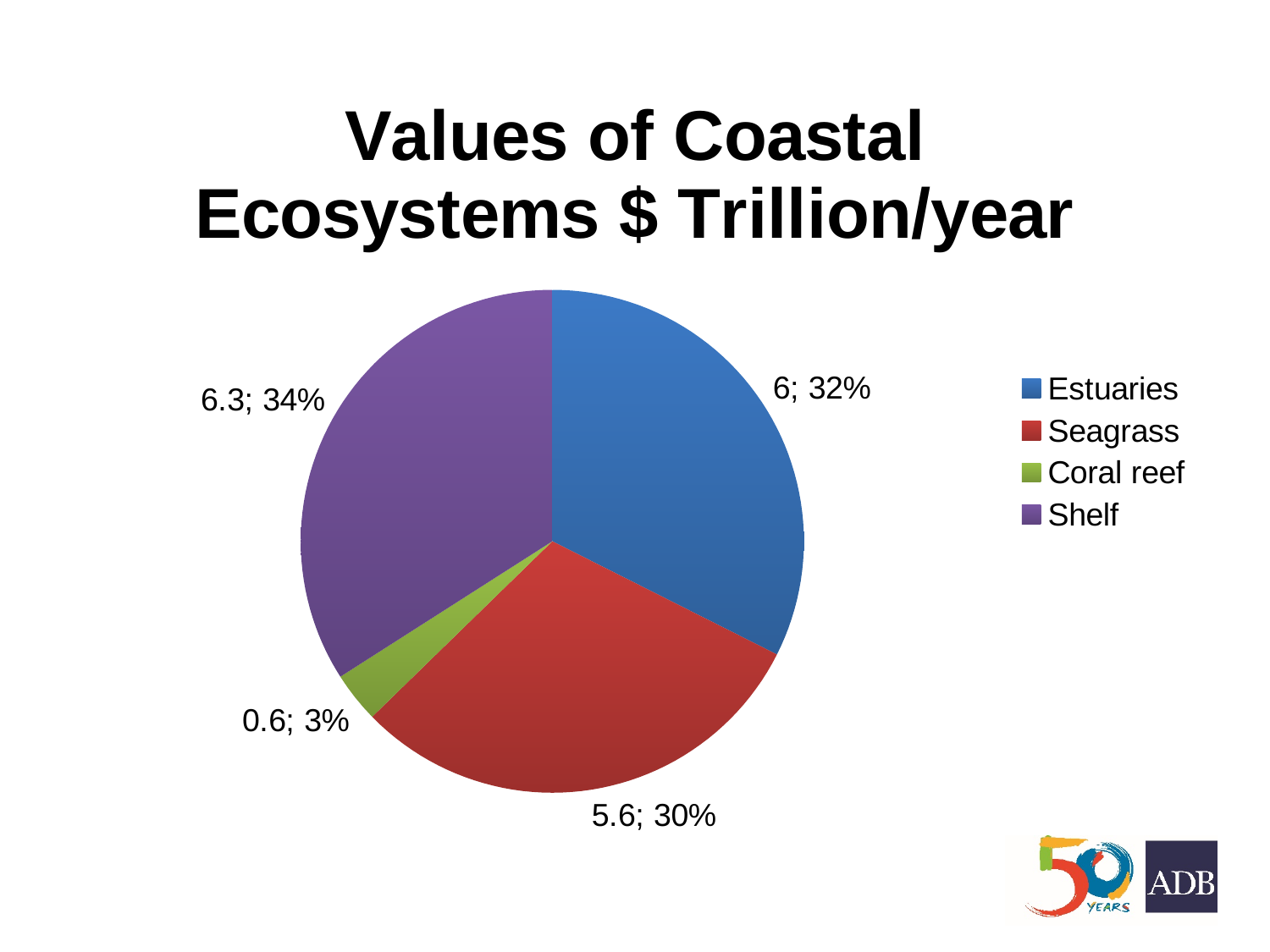
What kind of chart is shown on the slide? pie chart What is the value for Seagrass? 5.6 What is the value for Shelf? 6.3 What is the title of the chart? Values of Coastal Ecosystems $ Trillion/year Which category has the largest slice? Shelf How many categories does the pie chart have? 4 What is the value for Estuaries? 6 What is the value for Coral reef? 0.6 What share of the pie does Seagrass represent? 30% What is the difference between the values for Shelf and Seagrass? 0.7 What share of the pie does Coral reef represent? 3% Which category has the smallest slice? Coral reef